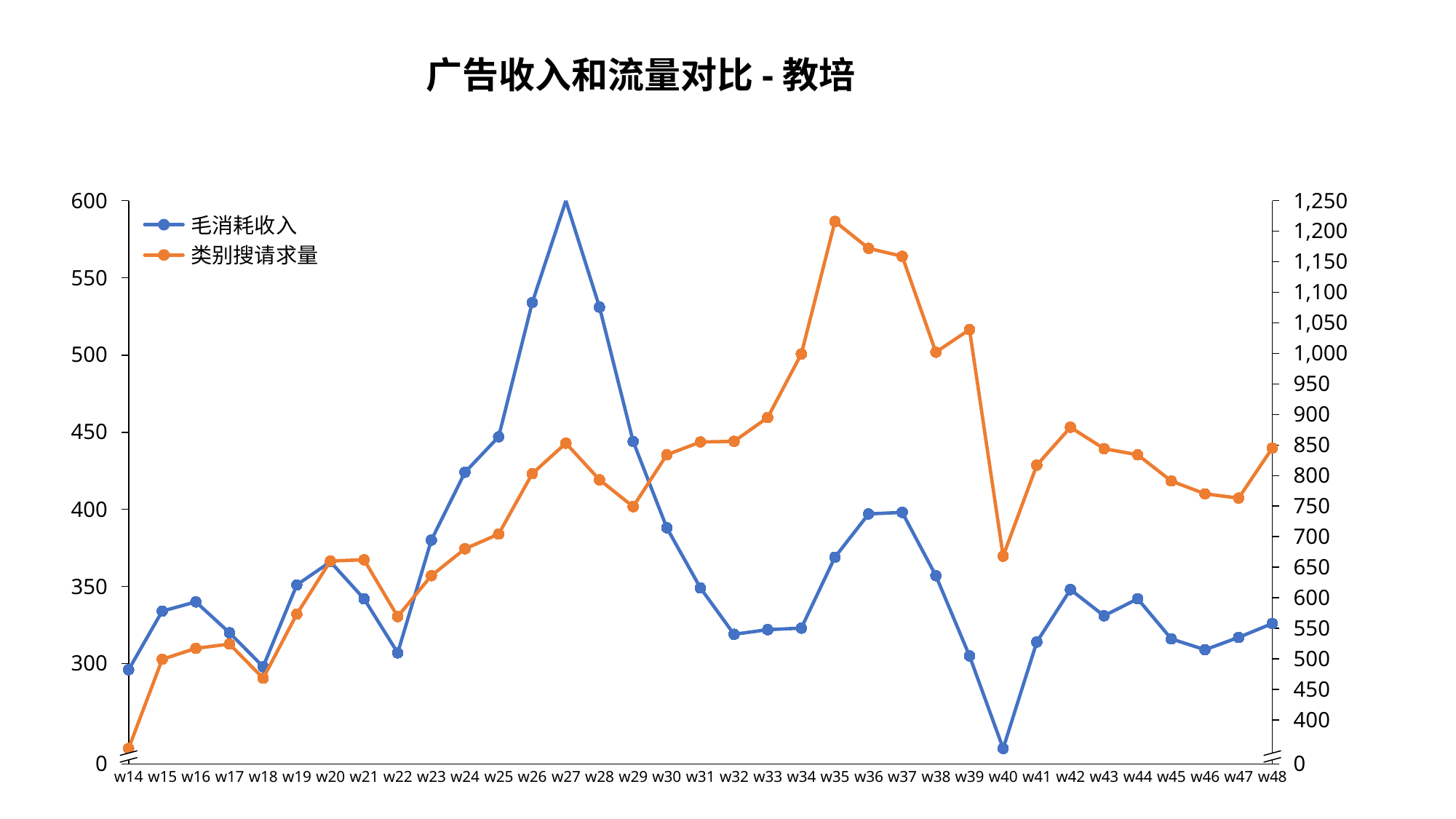
Is the value of 类别搜请求量 at w36 greater or less than 1,100? greater In which week is 毛消耗收入 at its lowest? w40 Is the value of 毛消耗收入 at w32 greater or less than 350? less How many weeks (categories) are plotted along the x axis? 35 Does 毛消耗收入 rise or fall from w27 to w32? fall In which week does 毛消耗收入 reach its highest value? w27 In which week is 类别搜请求量 at its lowest? w14 How many series does the legend list? 2 Is the value of 毛消耗收入 at w26 greater or less than 500? greater Which week has the higher 类别搜请求量, w35 or w38? w35 In which week does 类别搜请求量 reach its highest value? w35 What kind of chart is shown on the slide? line chart